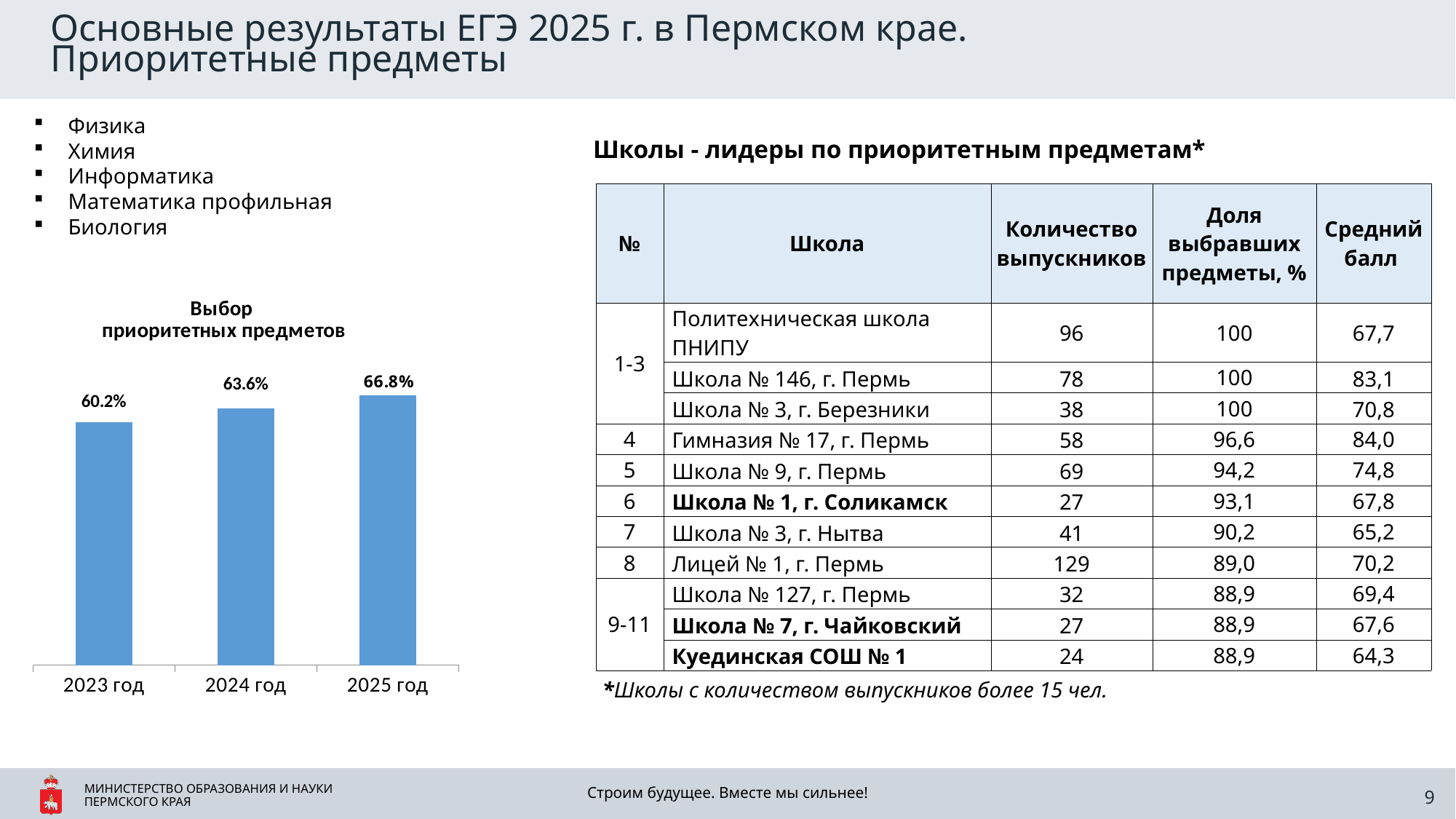
In the chart 'Выбор приоритетных предметов', which is larger: the value for 2024 год or 2025 год? 2025 год What is the difference between the values for 2024 год and 2023 год in the chart 'Выбор приоритетных предметов'? 3.4% What is the value for 2025 год in the chart 'Выбор приоритетных предметов'? 66.8% Which year has the lowest value in the chart 'Выбор приоритетных предметов'? 2023 год How many bars are shown in the chart 'Выбор приоритетных предметов'? 3 Which year has the highest value in the chart 'Выбор приоритетных предметов'? 2025 год What is the title of the bar chart on the slide? Выбор приоритетных предметов What is the difference between the values for 2025 год and 2023 год in the chart 'Выбор приоритетных предметов'? 6.6% Do the values in the chart 'Выбор приоритетных предметов' rise or fall from 2023 год to 2025 год? Rise What is the value for 2023 год in the chart 'Выбор приоритетных предметов'? 60.2% What is the value for 2024 год in the chart 'Выбор приоритетных предметов'? 63.6% What kind of chart is 'Выбор приоритетных предметов'? Bar chart